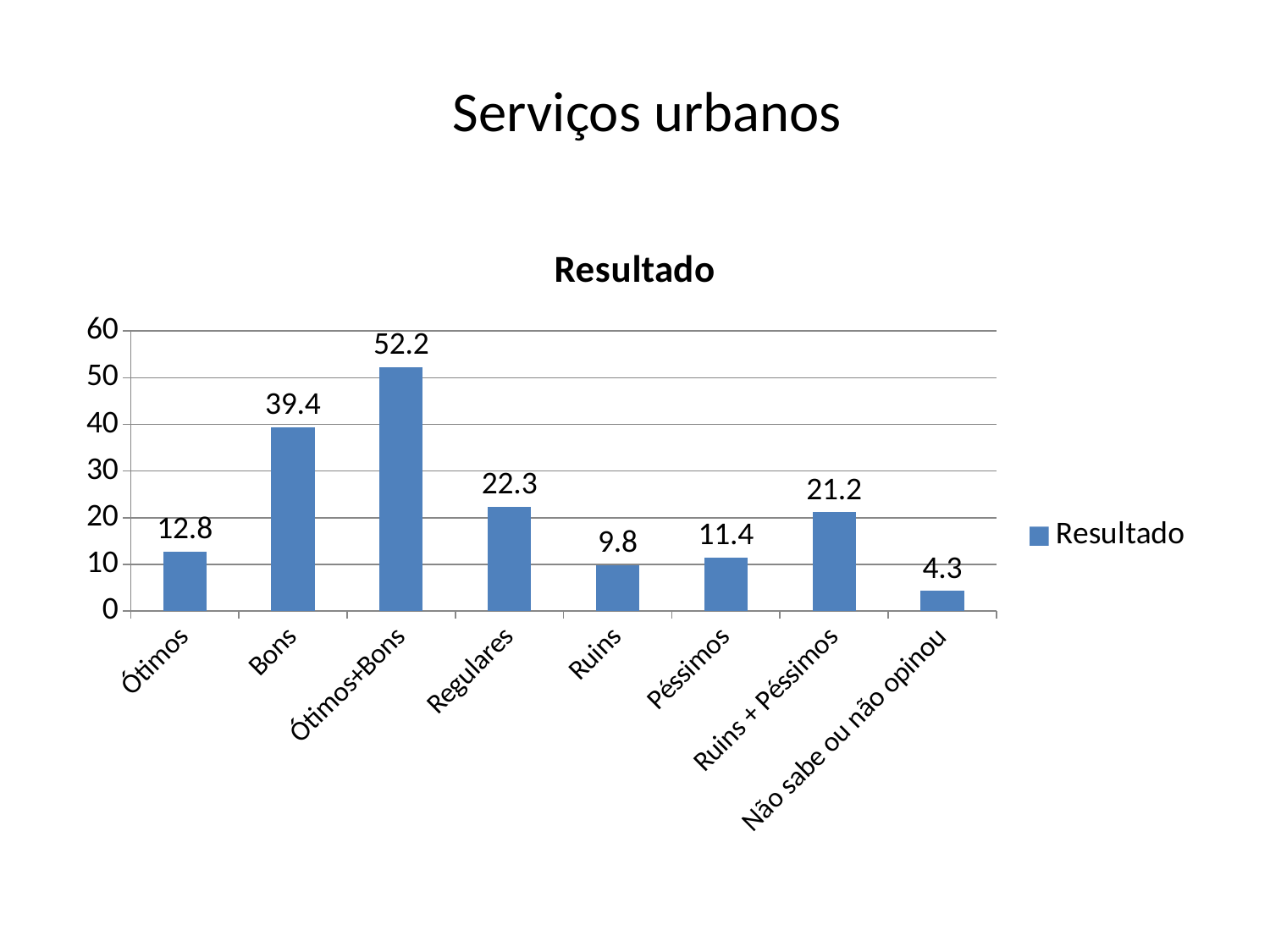
How many categories are shown on the x axis? 8 What is the title of the chart? Resultado What is the difference between the values for Bons and Ótimos? 26.6 Which category has the highest value? Ótimos+Bons How many series does the legend list? 1 What is the value for Não sabe ou não opinou? 4.3 Which category has the lowest value? Não sabe ou não opinou Which is larger, the value for Ruins or the value for Péssimos? Péssimos Is the value for Ruins + Péssimos greater or less than 20? greater What is the value for Ótimos? 12.8 What kind of chart is shown? bar chart What is the value for Regulares? 22.3